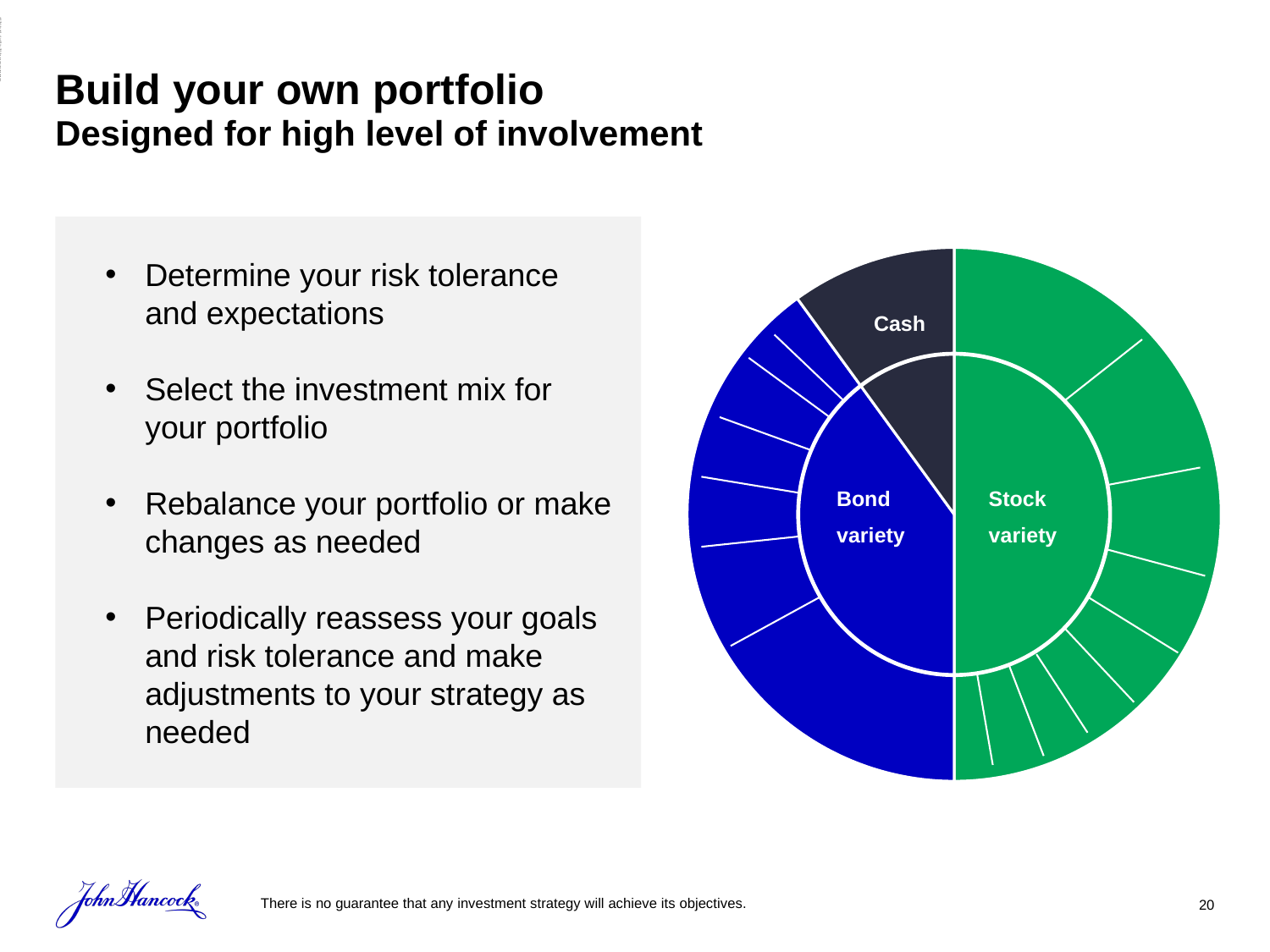
Which is larger in the pie chart, Stock variety or Bond variety? Stock variety Which is larger in the pie chart, Bond variety or Cash? Bond variety What kind of chart is shown on the right side of the slide? pie chart What colour is the Bond variety segment of the pie chart? blue How many categories does the pie chart on the slide show? 3 What colour is the Stock variety segment of the pie chart? green Which category takes up the smallest share of the pie chart? Cash Which category takes up the largest share of the pie chart? Stock variety